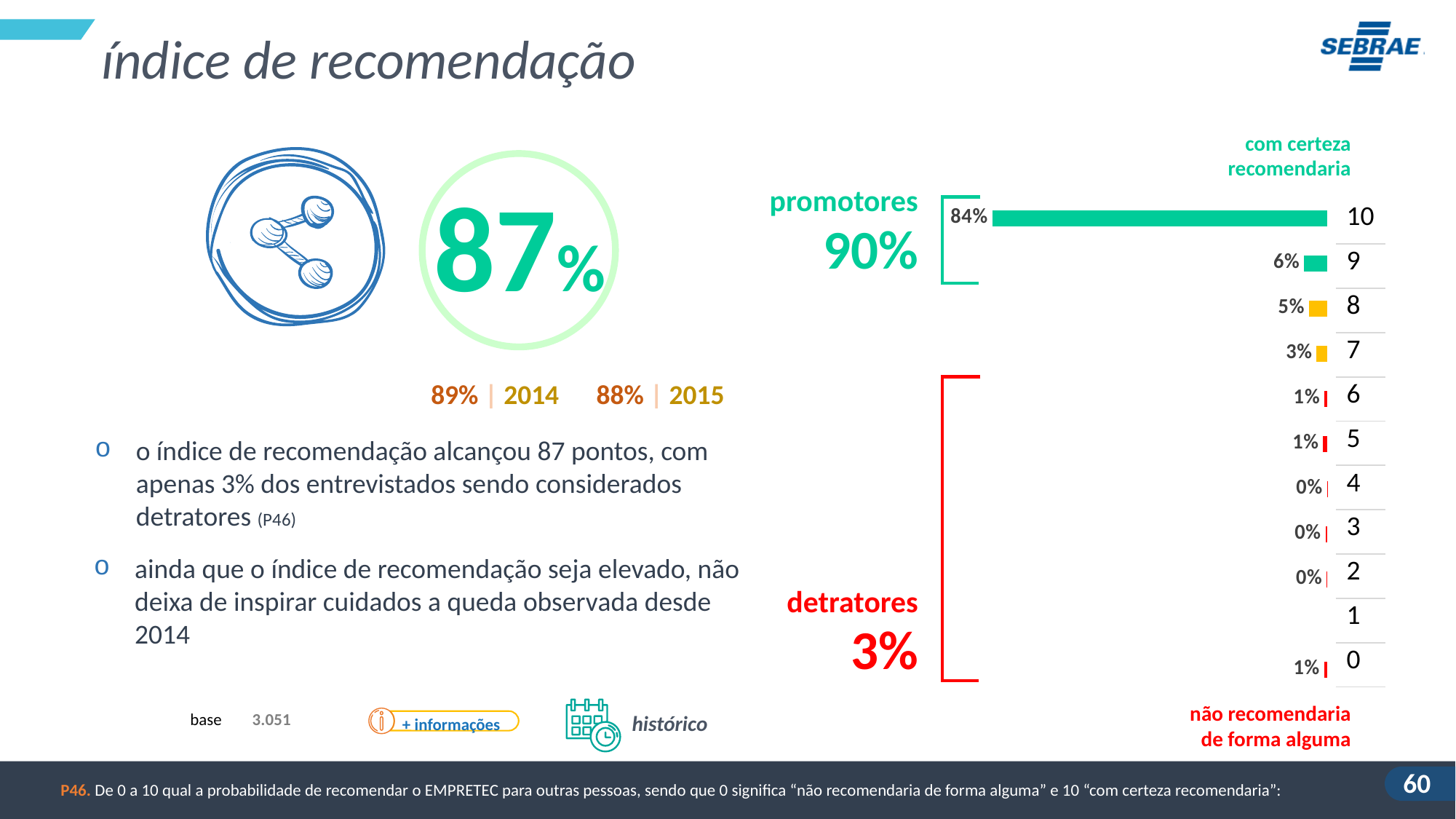
Which score has the highest percentage of respondents? 10 Which has a larger percentage, score 8 or score 7? score 8 What percentage of respondents gave a score of 7? 3% What percentage of respondents gave a score of 0? 1% What is the combined percentage of detratores shown on the chart? 3% What percentage of respondents gave a score of 8? 5% What percentage of respondents gave a score of 10 on the recommendation chart? 84% What is the difference between the percentage for score 8 and the percentage for score 7? 2% What kind of chart shows the distribution of scores from 0 to 10? bar chart What is the combined percentage of promotores shown on the chart? 90% What percentage of respondents gave a score of 9? 6% What is the difference between the percentage for score 10 and the percentage for score 9? 78%